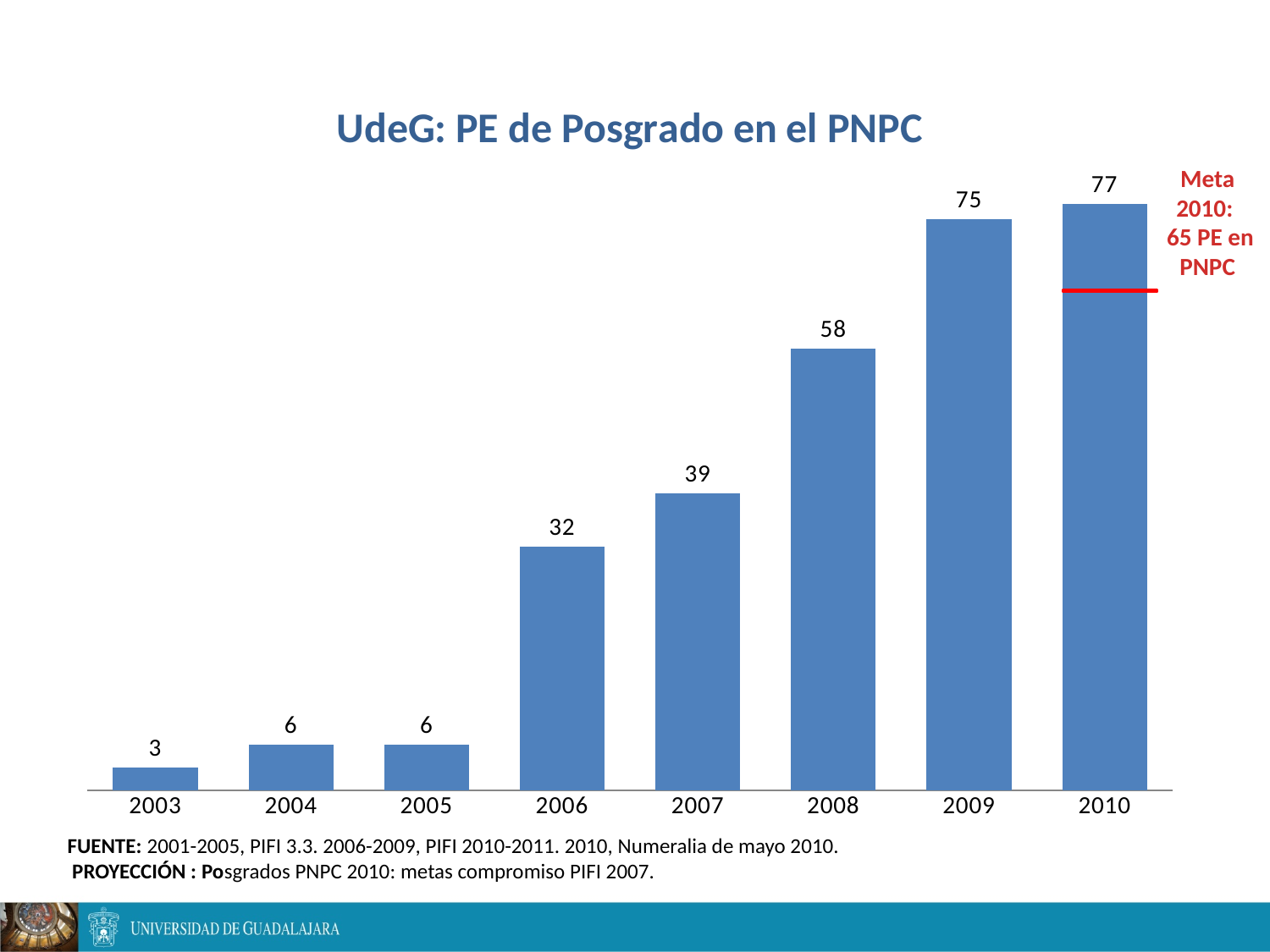
Which year has the lowest value? 2003 What is the value for 2006? 32 What kind of chart is this? Bar chart Which year has the highest value? 2010 What is the difference between the values for 2009 and 2008? 17 What is the title of the chart? UdeG: PE de Posgrado en el PNPC Which is larger, the value for 2007 or the value for 2006? 2007 How many years are shown on the x axis? 8 What is the value for 2003? 3 Do the values generally rise or fall from 2003 to 2010? Rise What is the difference between the values for 2010 and 2003? 74 What is the value for 2008? 58